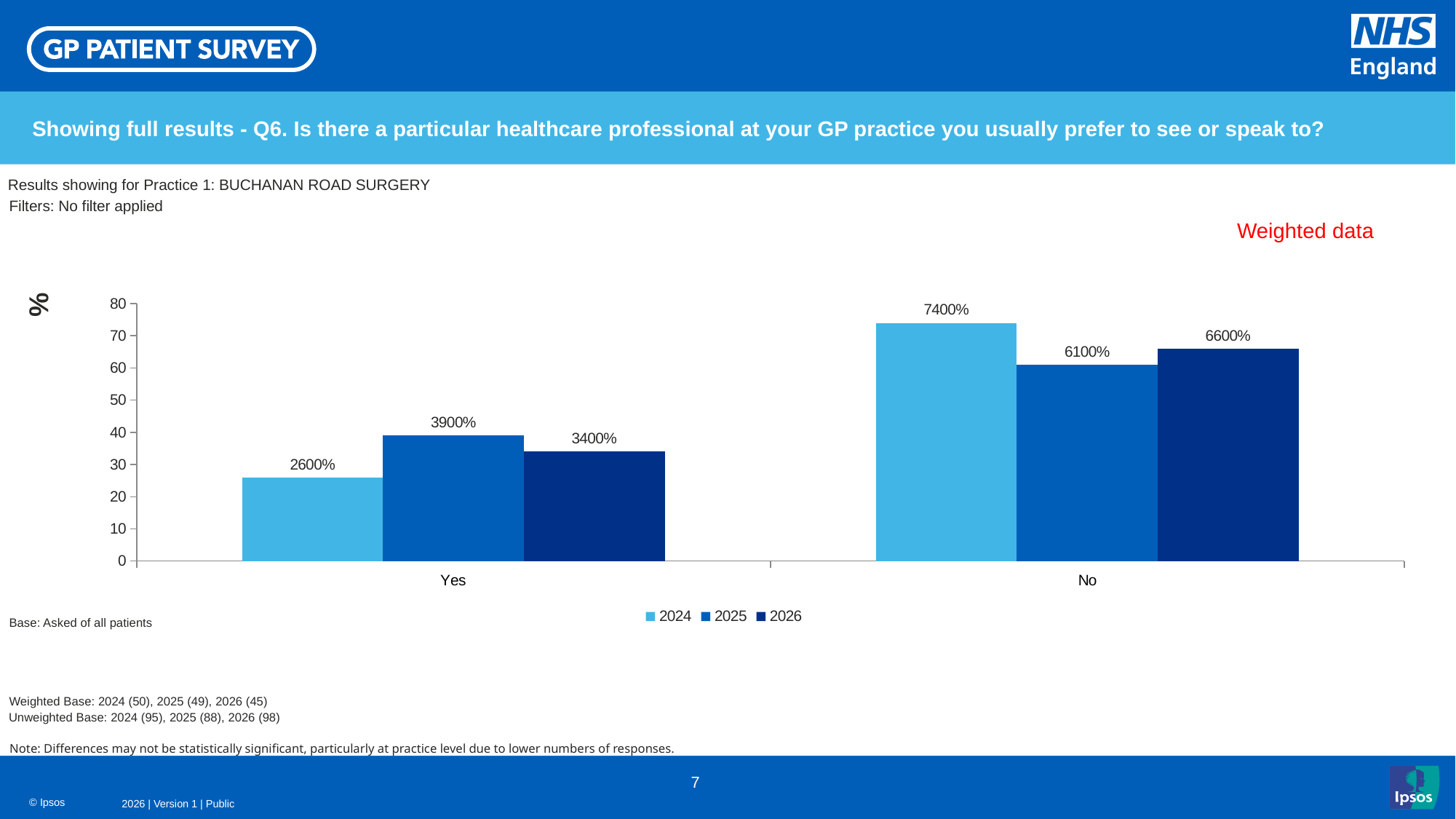
Is the 2026 bar in the No category greater or less than 60 on the axis? greater Which year has the highest bar in the No category? 2024 What kind of chart is shown on the slide? Bar chart What is the data label for 2024 in the No category? 7400% Which practice are the results shown for? Practice 1: BUCHANAN ROAD SURGERY How many categories are shown on the x axis? 2 Which is larger in the Yes category, the 2025 bar or the 2026 bar? 2025 What is the data label for 2025 in the No category? 6100% Which year has the lowest bar in the Yes category? 2024 What is the data label for 2024 in the Yes category? 2600% How many series does the legend list? 3 What is the data label for 2026 in the Yes category? 3400%